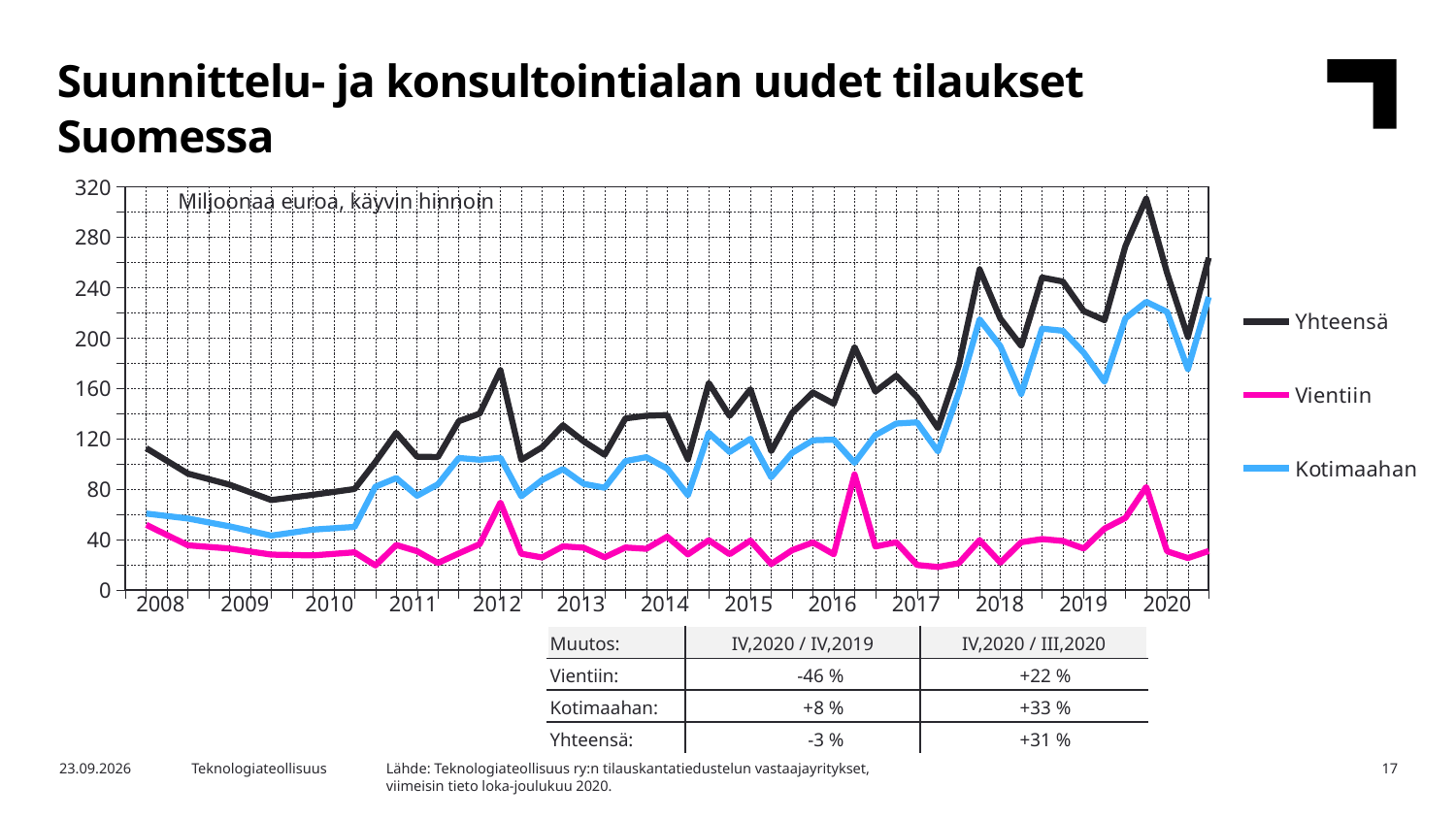
What kind of chart is shown on the slide? Line chart Does the Yhteensä line overall rise or fall from 2008 to 2020? Rise What are the three series named in the legend? Yhteensä, Vientiin, Kotimaahan Which series reaches the highest value on the chart? Yhteensä Is the value of the Kotimaahan line at the start of 2008 greater or less than 40? greater Is the highest value of the Vientiin line (in 2016) greater or less than 120? less Which series stays lowest across the whole period? Vientiin How many years are labelled on the x axis? 13 In 2018, which series has larger values, Kotimaahan or Vientiin? Kotimaahan How many series does the legend list? 3 What unit label is shown inside the chart area? Miljoonaa euroa, käyvin hinnoin